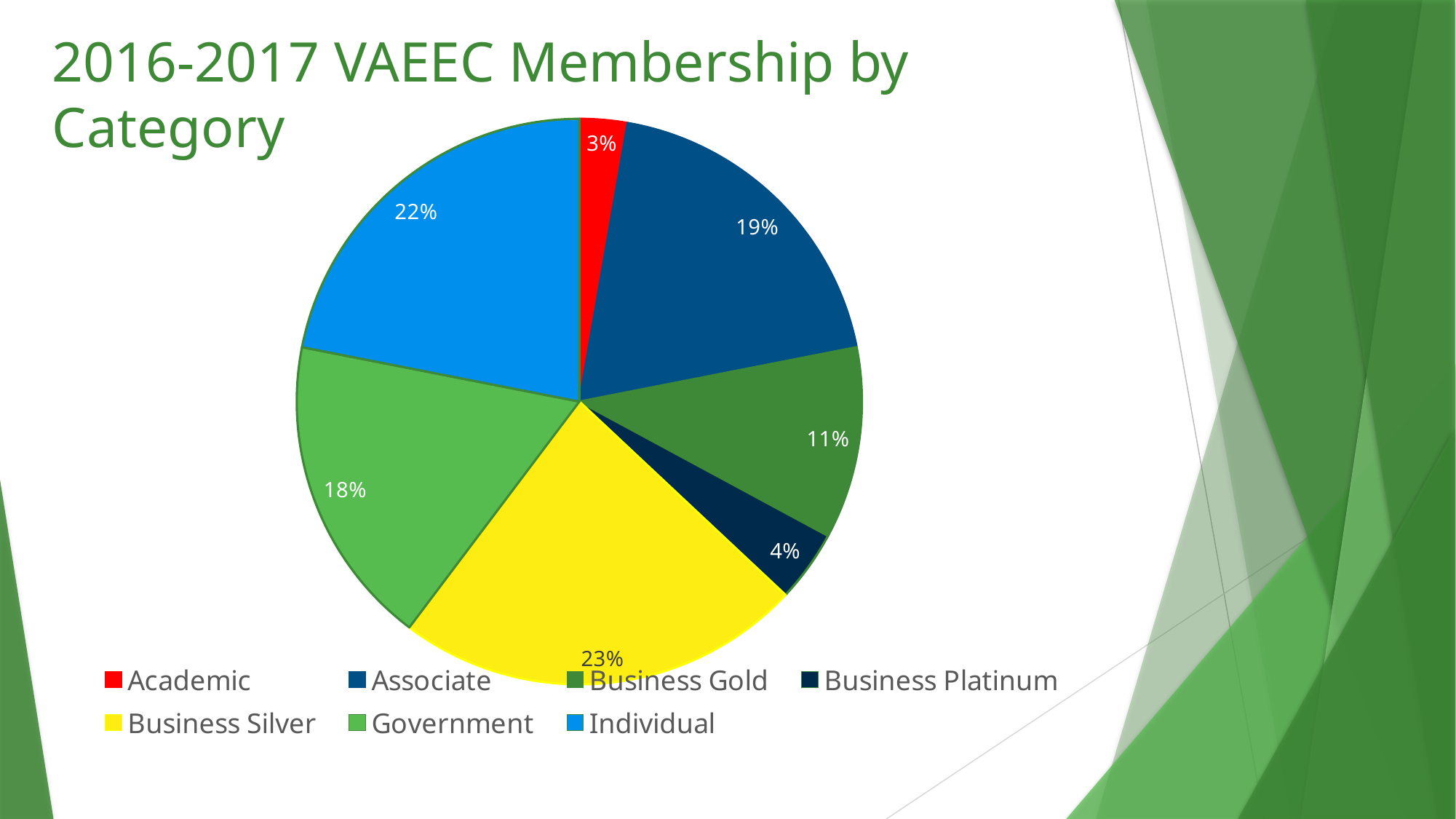
What kind of chart is shown on the slide? pie chart Which category has the largest share of membership? Business Silver Which category has the smallest share of membership? Academic What share of membership is Associate? 19% What is the difference in percentage points between Individual and Government? 4 How many categories does the pie chart show? 7 Which is larger, the Associate share or the Business Gold share? Associate What share of membership is Academic? 3% What share of membership is Individual? 22% What share of membership is Business Platinum? 4% What share of membership is Business Gold? 11% What share of membership is Business Silver? 23%